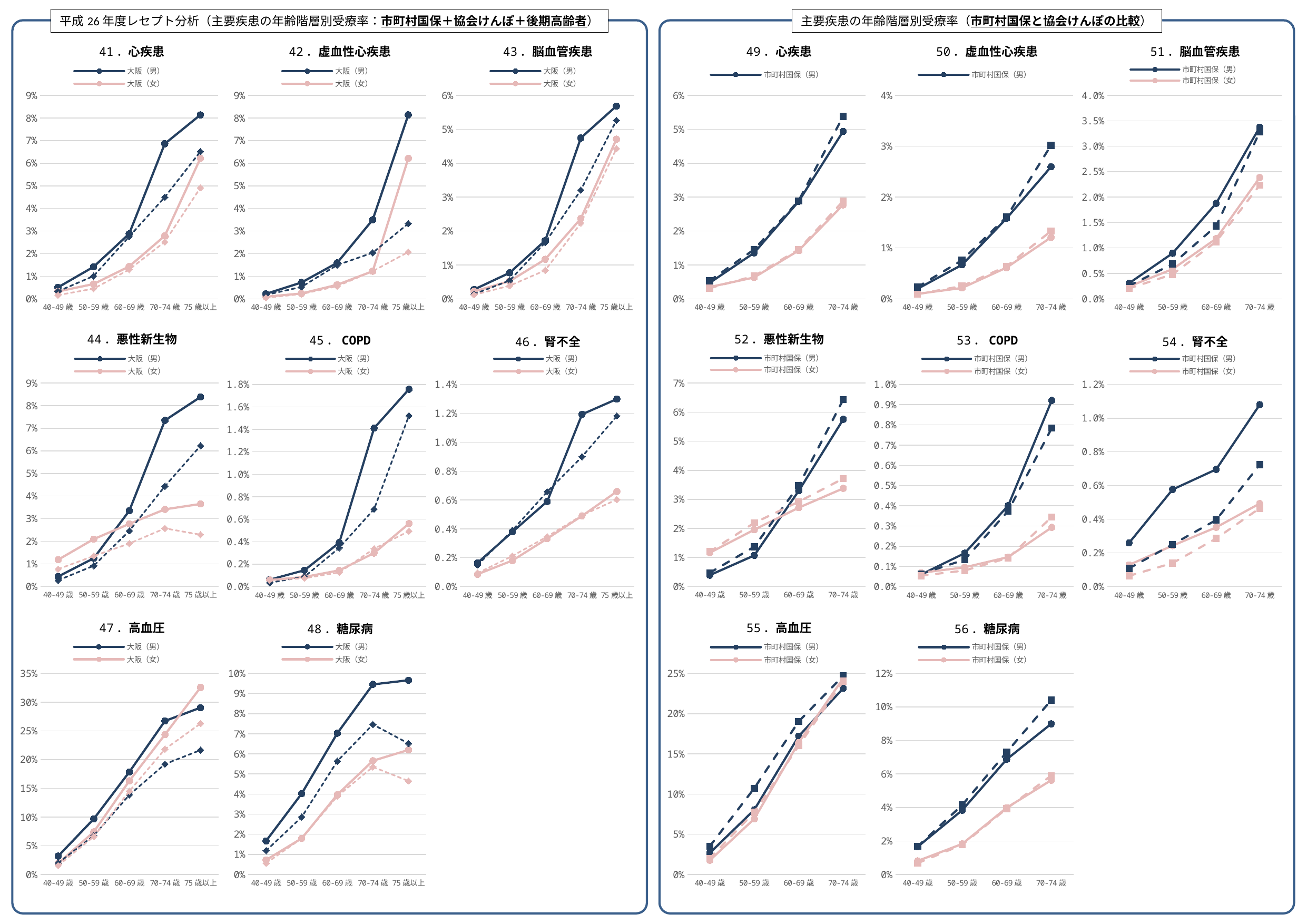
In the chart "48．糖尿病", is the value for 大阪（男） at 75歳以上 greater or less than 9%? greater What kind of chart is "41．心疾患" on the left panel? line chart In the chart "44．悪性新生物", is the value for 大阪（男） at 75歳以上 greater or less than 8%? greater In the chart "47．高血圧", which series is higher at 75歳以上, 大阪（男） or 大阪（女）? 大阪（女） In the chart "49．心疾患", does the 市町村国保（男） series rise or fall from 40-49歳 to 70-74歳? rise In the chart "47．高血圧", is the value for 大阪（女） at 75歳以上 greater or less than 30%? greater In the chart "41．心疾患", how many age categories are shown on the x axis? 5 How many series does the legend of the chart "44．悪性新生物" list? 2 What is the title of the chart in the bottom-left position of the left panel? 47．高血圧 In the chart "49．心疾患" on the right panel, how many age categories are shown on the x axis? 4 In the chart "52．悪性新生物", which series is higher at 40-49歳, 市町村国保（男） or 市町村国保（女）? 市町村国保（女）